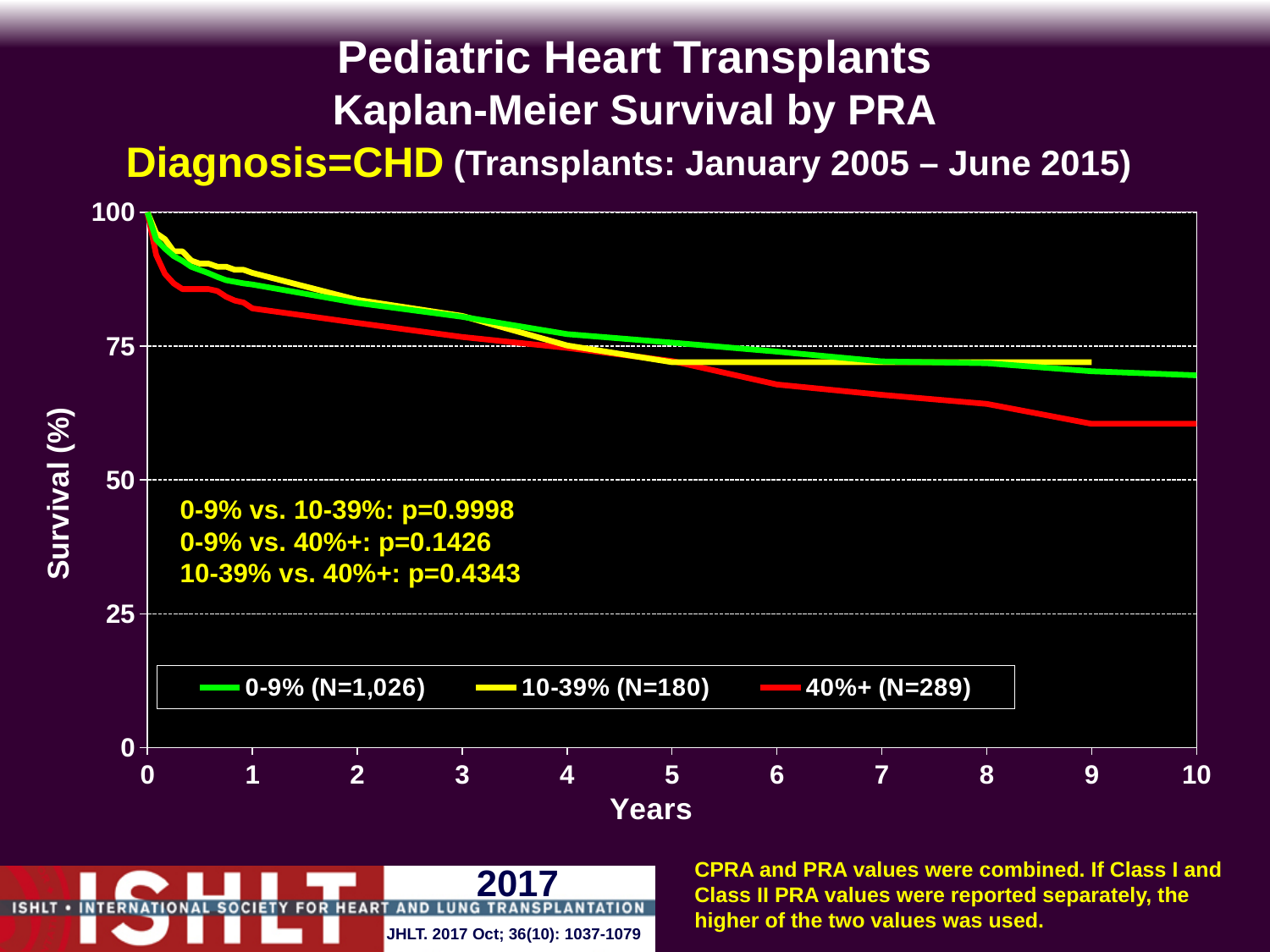
Is the survival for the 0-9% group at 10 years greater or less than 50? greater How many series does the legend list? 3 What is the N for the 0-9% PRA group shown in the legend? 1,026 Which PRA group has the lowest survival at 10 years? 40%+ What is the N for the 10-39% PRA group shown in the legend? 180 At 8 years, which group has higher survival, 0-9% or 40%+? 0-9% What p-value is shown for the comparison of 0-9% vs. 40%+? p=0.1426 What kind of chart is shown on the slide? Line chart What is the N for the 40%+ PRA group shown in the legend? 289 Is the survival for the 40%+ group at 10 years greater or less than 75? less Which PRA group has the highest survival at 10 years? 0-9% Do the survival curves rise or fall as years increase? fall